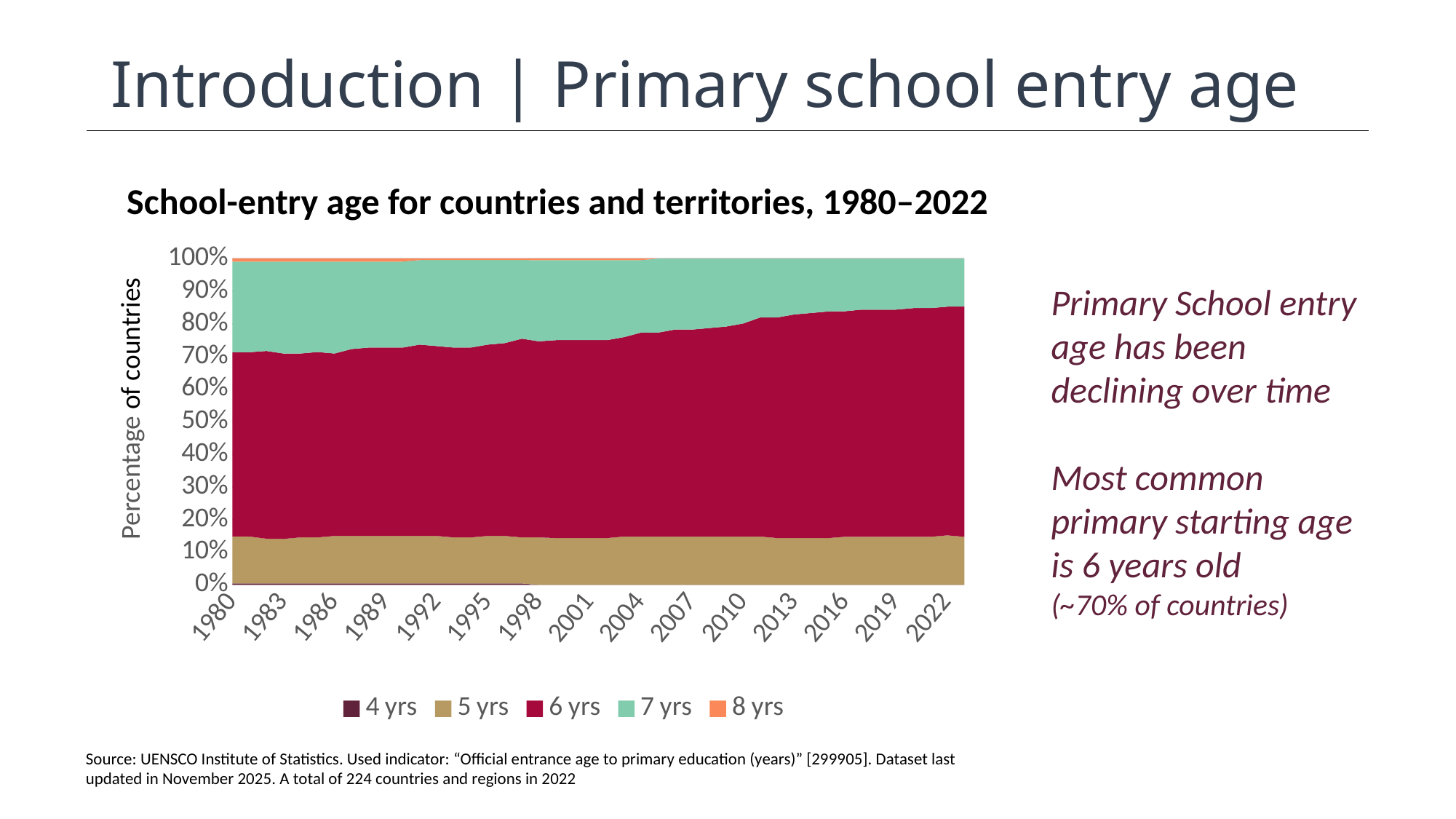
Does the share of countries with a 6 yrs entry age rise or fall from 1980 to 2022? Rise In 2022, is the share of countries with a 7 yrs entry age greater or less than 20%? less Does the share of countries with a 7 yrs entry age rise or fall from 1980 to 2022? Fall Which entry age series occupies the largest share of countries throughout the chart? 6 yrs Which is larger in 1980: the share of countries with a 7 yrs entry age or the share with a 5 yrs entry age? 7 yrs What is the title of the chart? School-entry age for countries and territories, 1980–2022 How many series does the chart legend list? 5 How many year labels are shown on the horizontal axis? 15 In 2022, is the share of countries with a 5 yrs entry age greater or less than 20%? less What kind of chart is shown on the slide? Stacked area chart What is the label on the vertical axis of the chart? Percentage of countries In 2022, is the combined share of countries with an entry age of 6 yrs or younger greater or less than 80%? greater